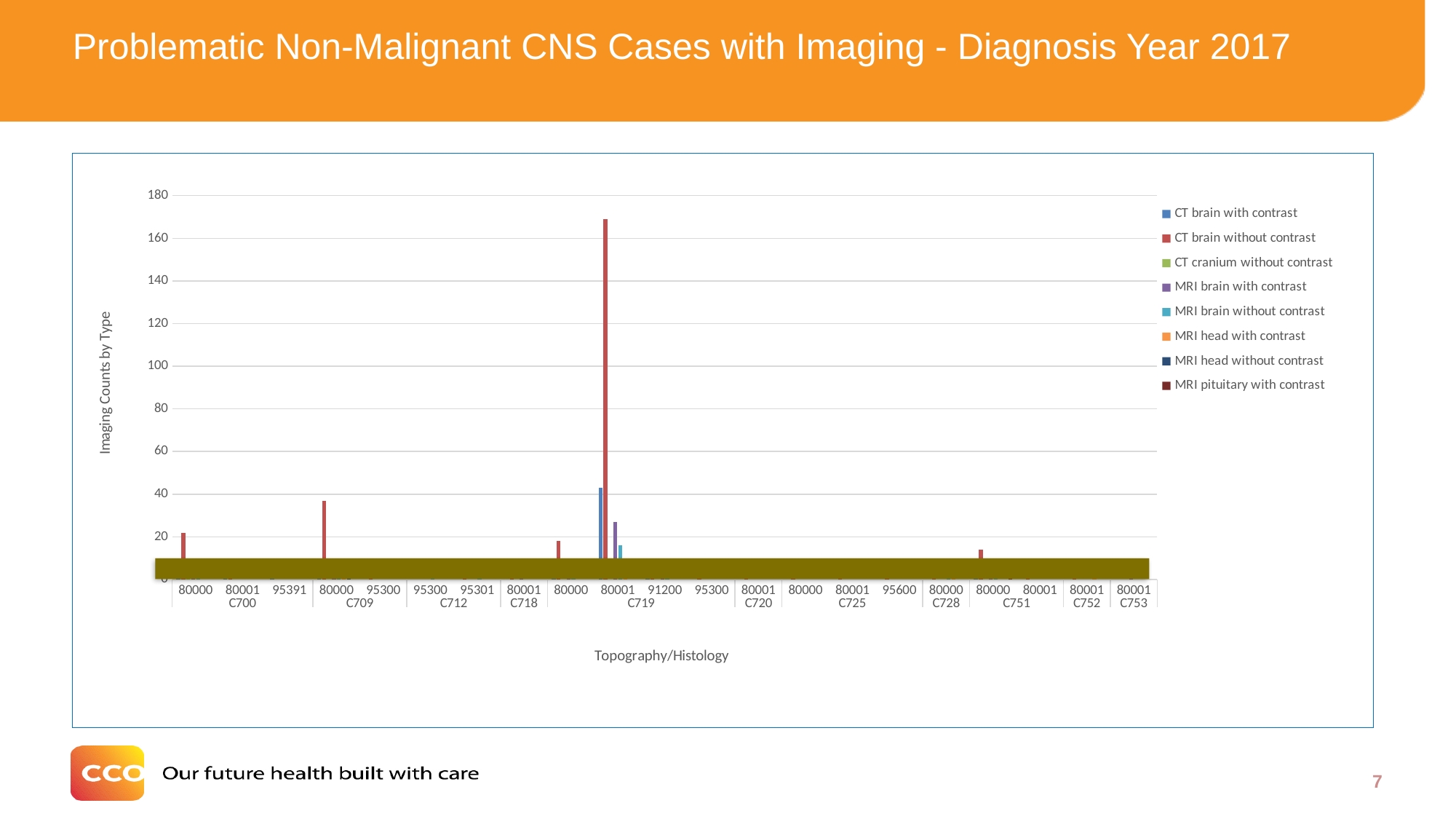
What kind of chart is shown on the slide? bar chart What is the label of the x axis? Topography/Histology How many topography groups (C-codes) are labelled along the x axis? 11 Is the value for CT brain without contrast at C719 80001 greater or less than 160? greater Is the value for MRI brain with contrast at C719 80001 greater or less than 40? less Is the value for CT brain without contrast at C709 80000 greater or less than 40? less Which series has the tallest bar on the chart? CT brain without contrast Which is larger at C719 80001: CT brain without contrast or CT brain with contrast? CT brain without contrast What is the label of the y axis? Imaging Counts by Type How many series does the legend list? 8 In which topography/histology category does the tallest bar appear? C719 80001